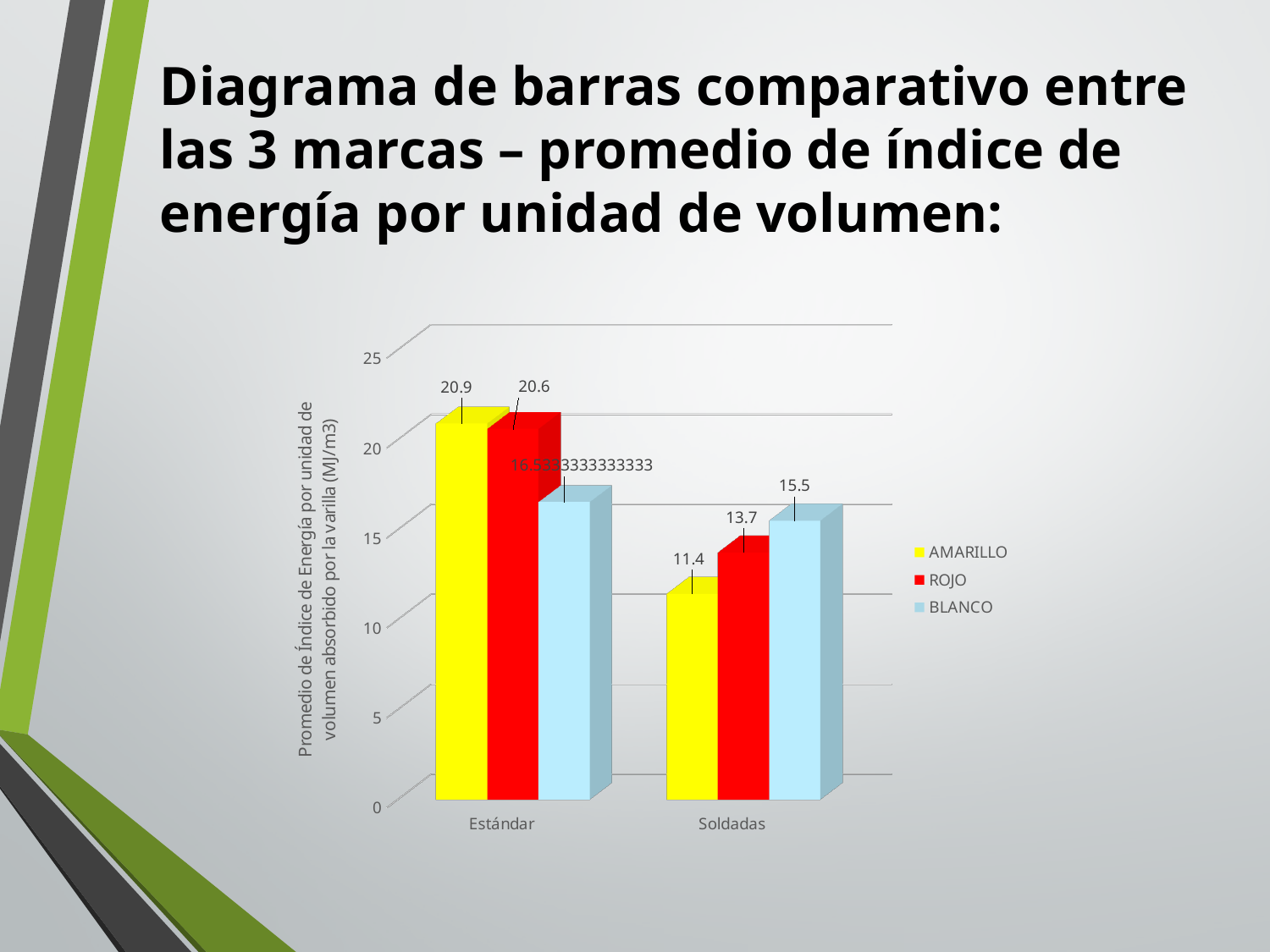
What is the value for BLANCO in the Soldadas category? 15.5 What is the value for ROJO in the Estándar category? 20.6 What kind of chart is shown on the slide? bar chart How many series does the legend list? 3 What is the value for AMARILLO in the Estándar category? 20.9 Which series has the lowest value in the Soldadas category? AMARILLO For AMARILLO, which category has the larger value, Estándar or Soldadas? Estándar Which series has the highest value in the Soldadas category? BLANCO What is the difference between the BLANCO and AMARILLO values in the Soldadas category? 4.1 Is the value for BLANCO in the Estándar category greater or less than 15? greater What is the value for AMARILLO in the Soldadas category? 11.4 What is the value for ROJO in the Soldadas category? 13.7